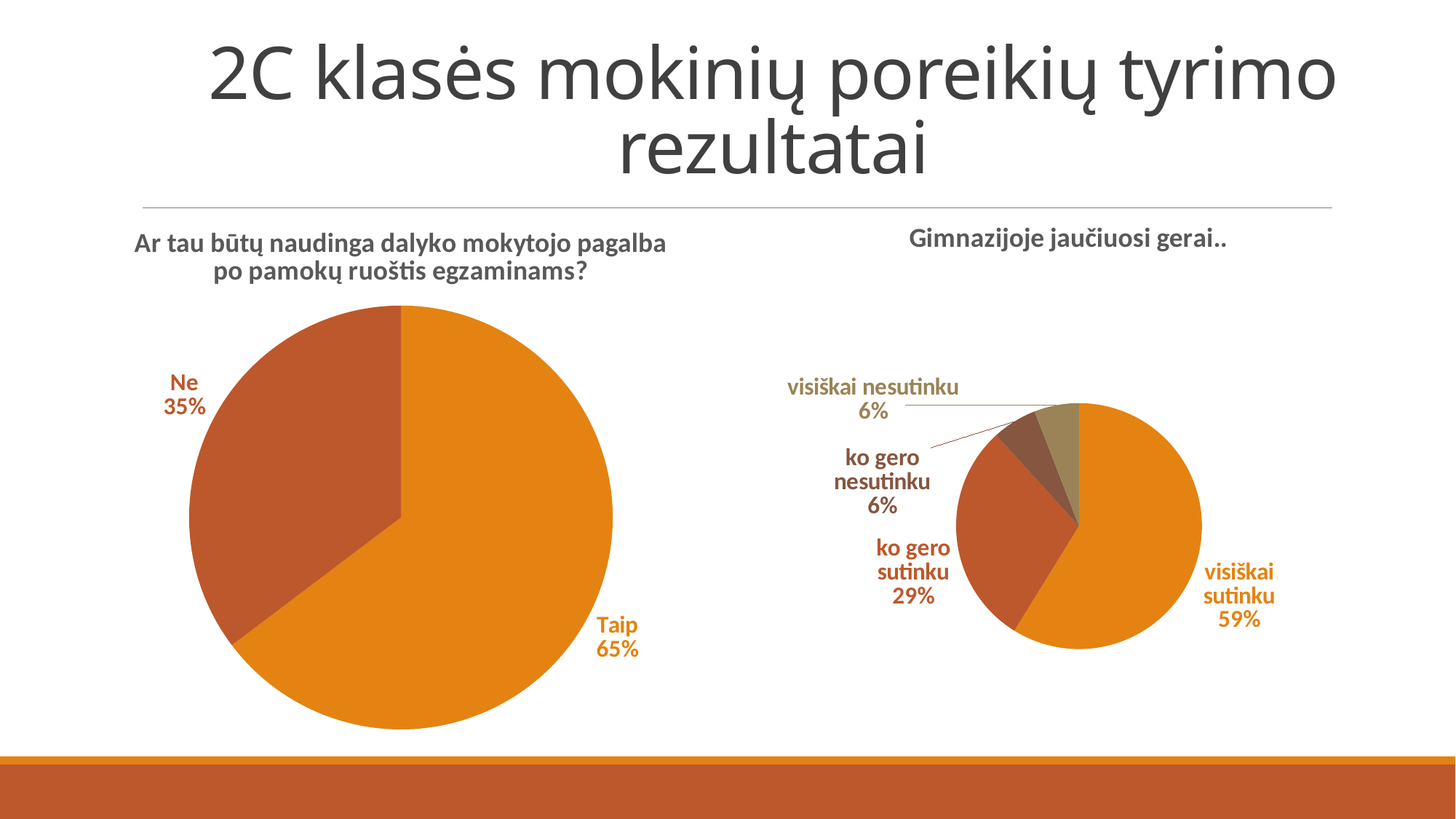
In the left chart 'Ar tau būtų naudinga dalyko mokytojo pagalba po pamokų ruoštis egzaminams?', what is the value for 'Ne'? 35% In the right chart 'Gimnazijoje jaučiuosi gerai..', what is the value for 'visiškai nesutinku'? 6% In the left chart 'Ar tau būtų naudinga dalyko mokytojo pagalba po pamokų ruoštis egzaminams?', what share of the pie is 'Taip'? 65% In the right chart 'Gimnazijoje jaučiuosi gerai..', which is larger, 'ko gero sutinku' or 'ko gero nesutinku'? ko gero sutinku In the right chart 'Gimnazijoje jaučiuosi gerai..', which slice is the largest? visiškai sutinku In the left chart 'Ar tau būtų naudinga dalyko mokytojo pagalba po pamokų ruoštis egzaminams?', which slice is the largest? Taip In the right chart 'Gimnazijoje jaučiuosi gerai..', how many slices does the pie have? 4 In the right chart 'Gimnazijoje jaučiuosi gerai..', what share of the pie is 'visiškai sutinku'? 59% In the right chart 'Gimnazijoje jaučiuosi gerai..', what is the value for 'ko gero sutinku'? 29% In the left chart 'Ar tau būtų naudinga dalyko mokytojo pagalba po pamokų ruoštis egzaminams?', what is the difference between 'Taip' and 'Ne'? 30% In the left chart 'Ar tau būtų naudinga dalyko mokytojo pagalba po pamokų ruoštis egzaminams?', how many slices does the pie have? 2 What kind of chart is the right chart 'Gimnazijoje jaučiuosi gerai..'? Pie chart